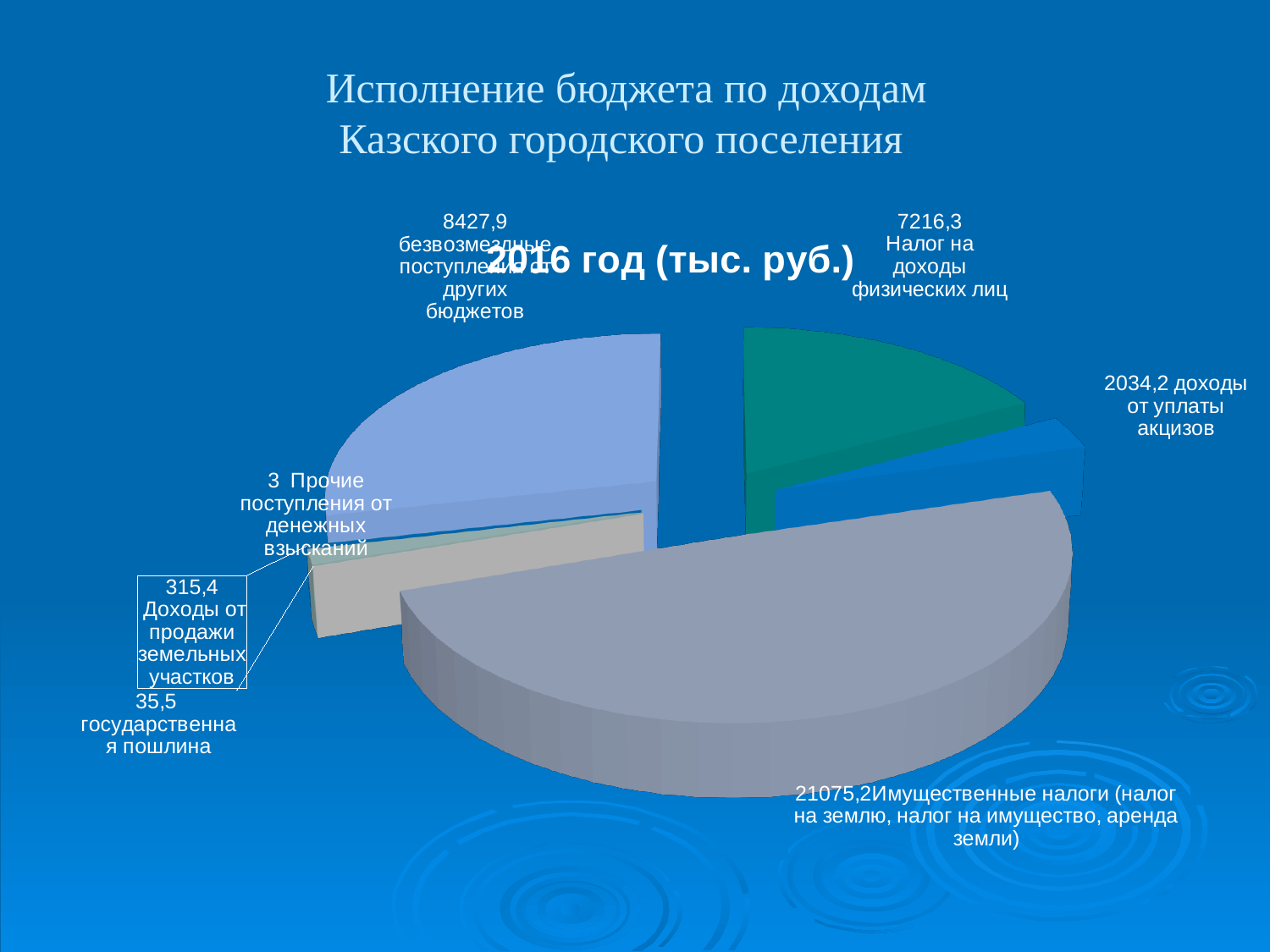
What is the value for доходы от уплаты акцизов? 2034,2 What is the value for безвозмездные поступления от других бюджетов? 8427,9 What kind of chart is shown on the slide? Pie chart What is the title of the chart? 2016 год (тыс. руб.) Which is larger: безвозмездные поступления от других бюджетов or Налог на доходы физических лиц? безвозмездные поступления от других бюджетов Which category has the largest slice of the pie? Имущественные налоги (налог на землю, налог на имущество, аренда земли) What is the value for Имущественные налоги (налог на землю, налог на имущество, аренда земли)? 21075,2 Which category has the smallest value? Прочие поступления от денежных взысканий What is the difference between Доходы от продажи земельных участков and государственная пошлина? 279,9 What is the value for государственная пошлина? 35,5 What is the value for Налог на доходы физических лиц? 7216,3